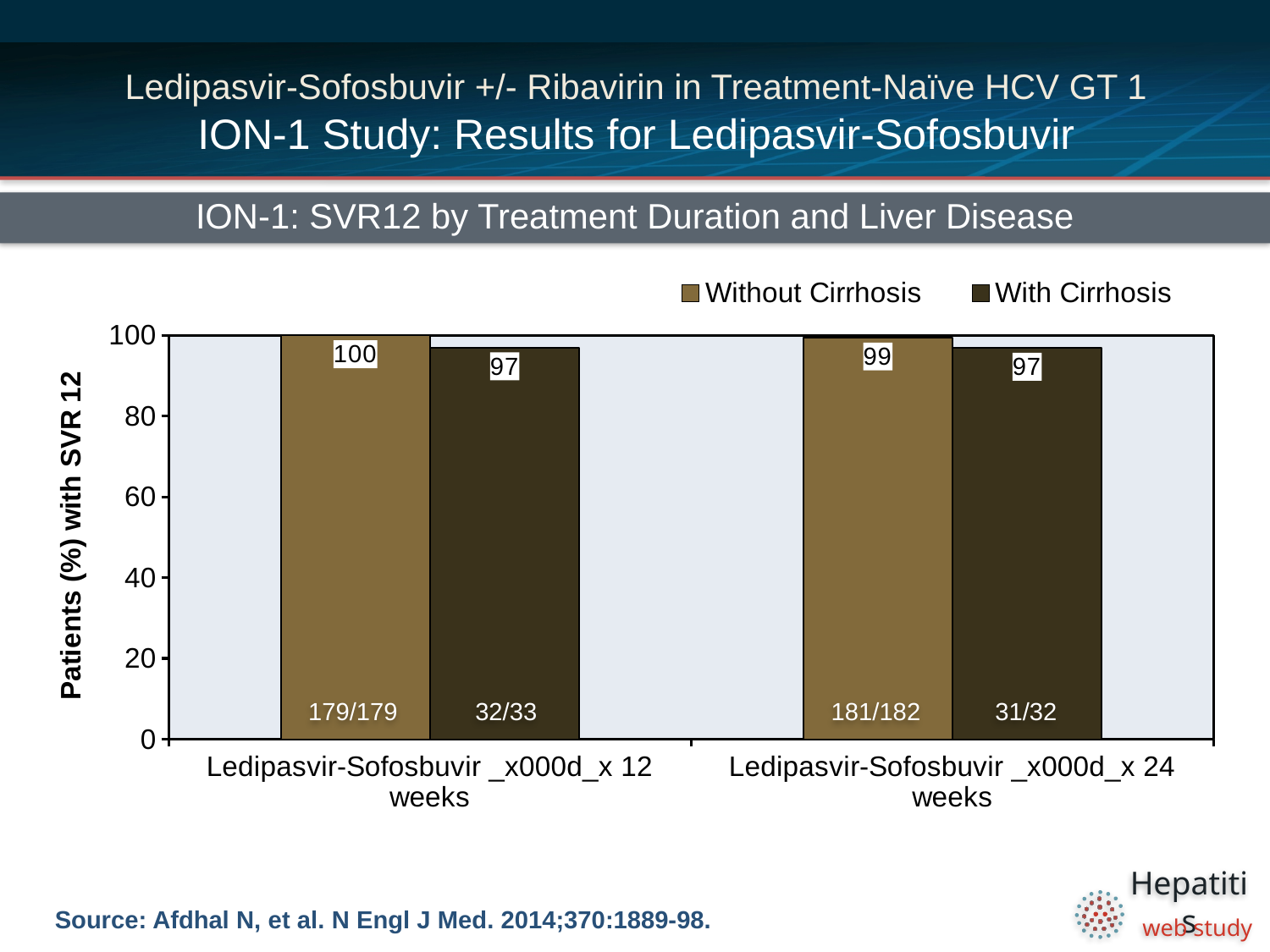
What is the difference between the SVR12 rates for patients without cirrhosis and with cirrhosis in the 24-week group? 2 Which bar has the highest SVR12 rate? Without Cirrhosis, 12 weeks What is the SVR12 rate for patients without cirrhosis treated with Ledipasvir-Sofosbuvir for 12 weeks? 100 What kind of chart is shown on the slide? Bar chart In the 12-week group, which has the higher SVR12 rate: patients without cirrhosis or with cirrhosis? Without Cirrhosis How many series does the legend list? 2 What fraction of patients is shown on the bar for patients without cirrhosis treated for 24 weeks? 181/182 What is the SVR12 rate for patients with cirrhosis treated with Ledipasvir-Sofosbuvir for 24 weeks? 97 What is the SVR12 rate for patients without cirrhosis treated with Ledipasvir-Sofosbuvir for 24 weeks? 99 What is the label of the y axis? Patients (%) with SVR 12 What fraction of patients is shown on the bar for patients with cirrhosis treated for 12 weeks? 32/33 What is the difference between the SVR12 rates for patients without cirrhosis and with cirrhosis in the 12-week group? 3